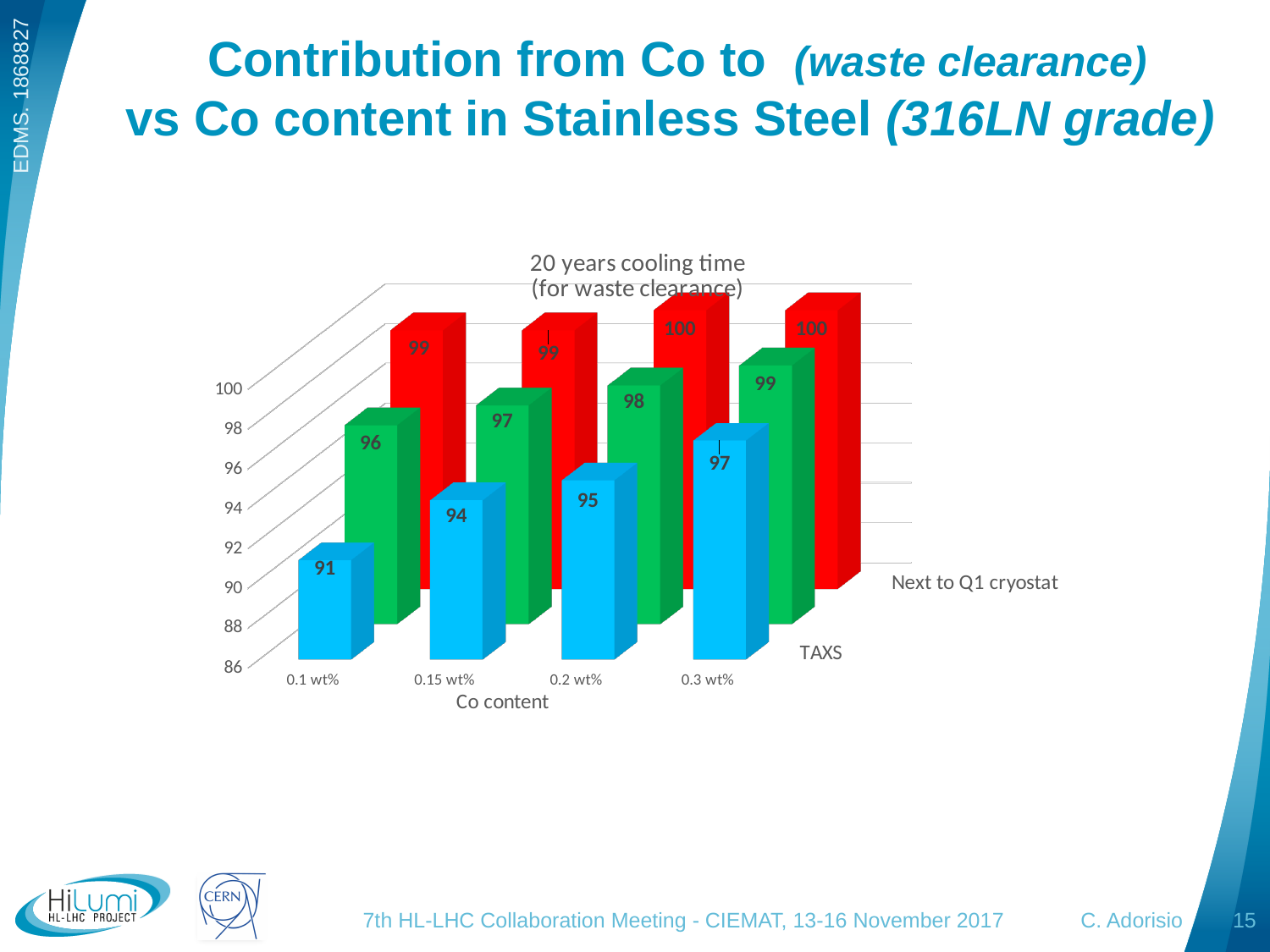
At which Co content is the TAXS value lowest? 0.1 wt% How many Co content categories are shown on the x axis? 4 What is the value for Next to Q1 cryostat at 0.2 wt% Co content? 100 What is the value for TAXS at 0.1 wt% Co content? 91 What is the difference between the TAXS values at 0.3 wt% and 0.1 wt%? 6 Do the TAXS values rise or fall as Co content increases from 0.1 wt% to 0.3 wt%? Rise What is the value for TAXS at 0.3 wt% Co content? 97 What kind of chart is shown on the slide? Bar chart At 0.1 wt% Co content, how much larger is the Next to Q1 cryostat value than the TAXS value? 8 What is the value for Next to Q1 cryostat at 0.1 wt% Co content? 99 For TAXS, which has the larger value: 0.15 wt% or 0.2 wt%? 0.2 wt% At which Co content is the TAXS value highest? 0.3 wt%